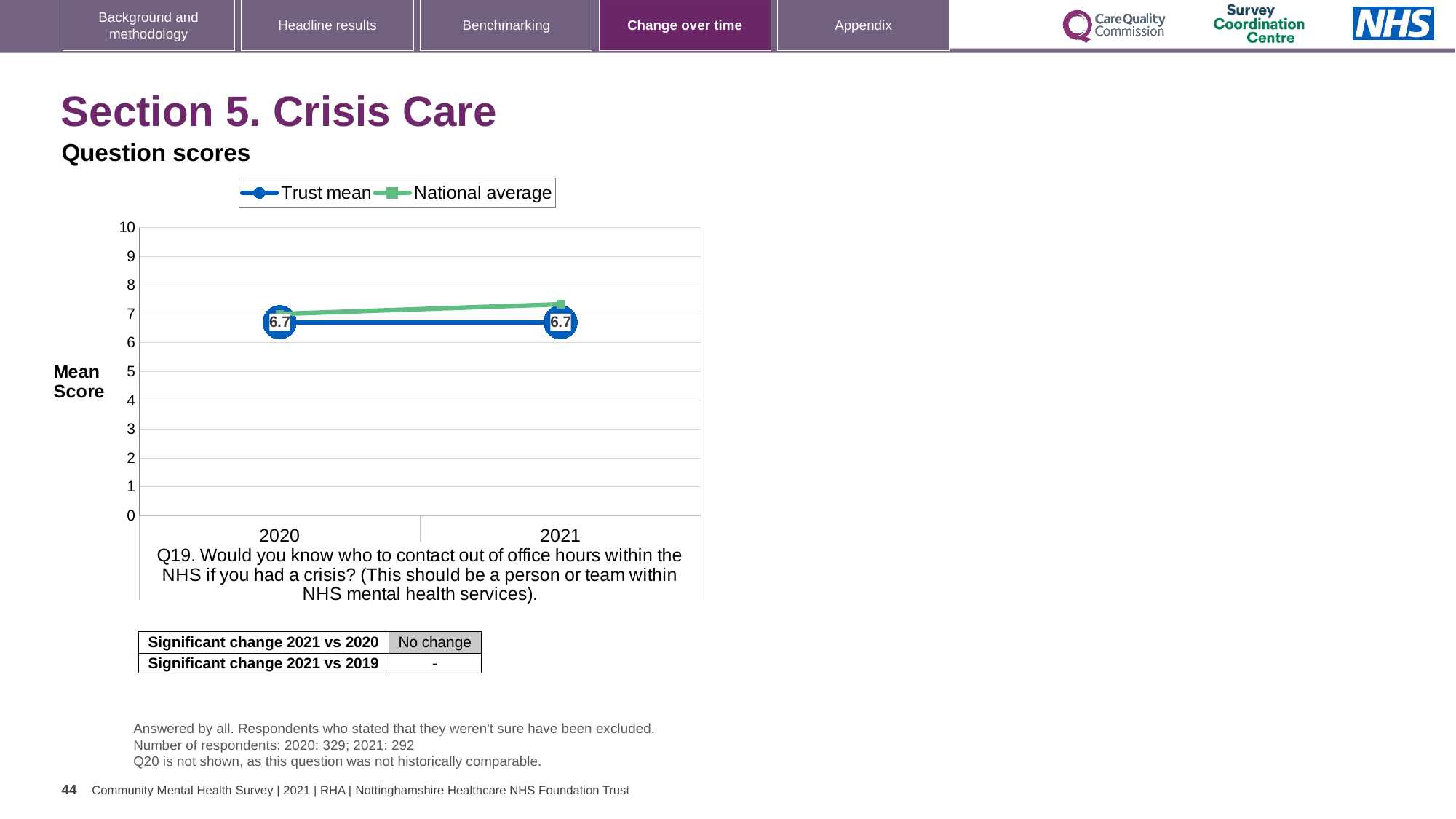
How many years are plotted along the x axis? 2 What is the label on the chart's y axis? Mean Score What is the difference between the Trust mean in 2021 and in 2020? 0 How many series does the chart legend list? 2 Is the National average for 2021 greater or less than 7? greater Does the Trust mean rise, fall or stay the same from 2020 to 2021? Stays the same In 2021, which is higher: the Trust mean or the National average? National average What is the Trust mean score for 2020? 6.7 What type of chart is shown on the slide? Line chart What is the Trust mean score for 2021? 6.7 Does the National average rise or fall from 2020 to 2021? Rises What are the two series named in the chart legend? Trust mean and National average